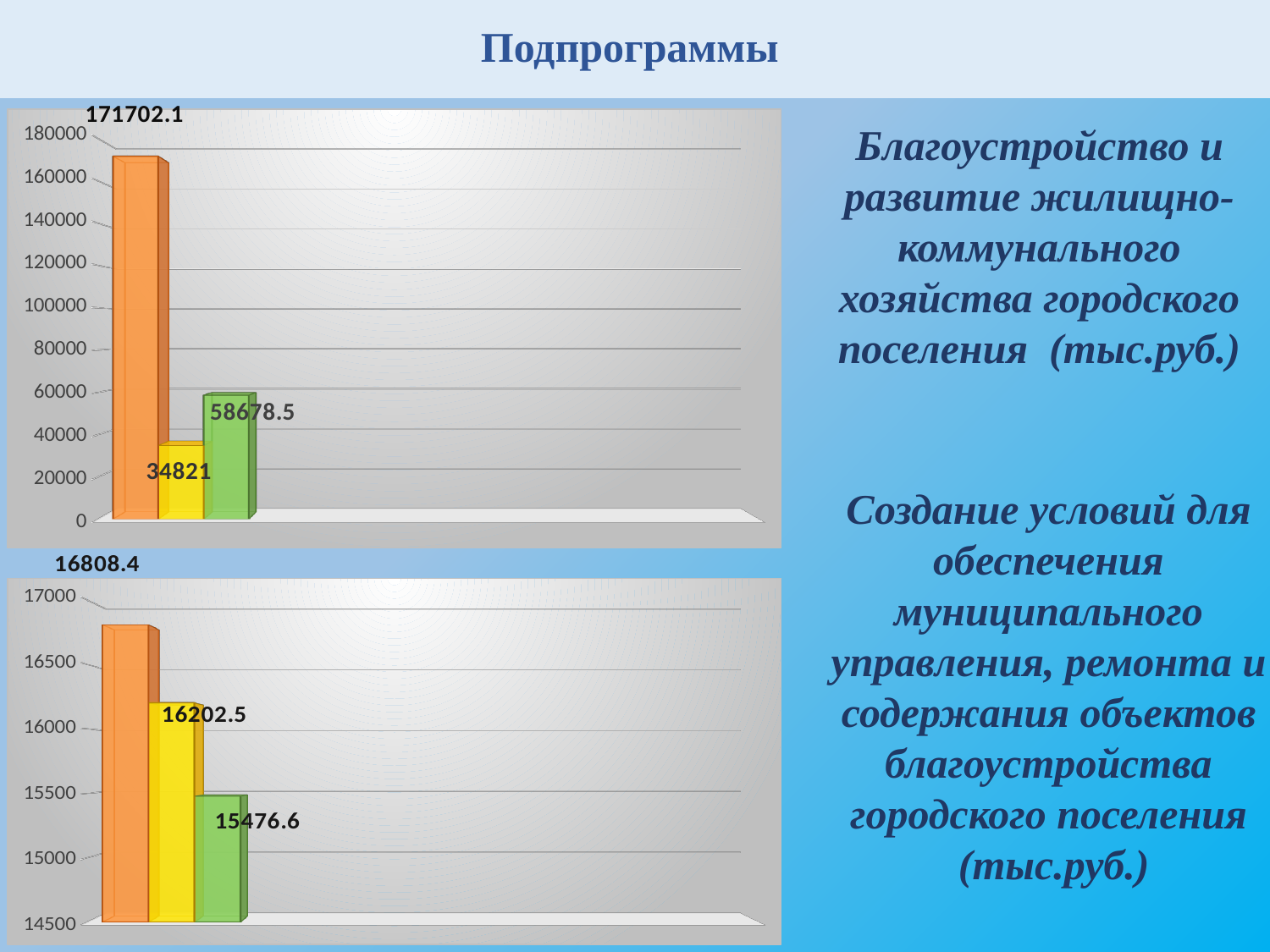
In the top chart, which bar has the lowest value? the yellow (second) bar, 34821 What type of chart is the top chart on the slide? bar chart In the top chart, what is the value shown on the green (third) bar? 58678.5 In the bottom chart, do the values rise or fall from the first bar to the third bar? fall In the top chart, what is the value shown on the orange (first) bar? 171702.1 How many bars are plotted in the top chart? 3 In the top chart, what is the difference between the orange bar and the green bar? 113023.6 In the bottom chart, which bar has the highest value? the orange (first) bar, 16808.4 In the bottom chart, what is the value shown on the orange (first) bar? 16808.4 In the bottom chart, what is the value shown on the green (third) bar? 15476.6 In the bottom chart, what is the difference between the yellow bar and the green bar? 725.9 In the top chart, what is the value shown on the yellow (second) bar? 34821